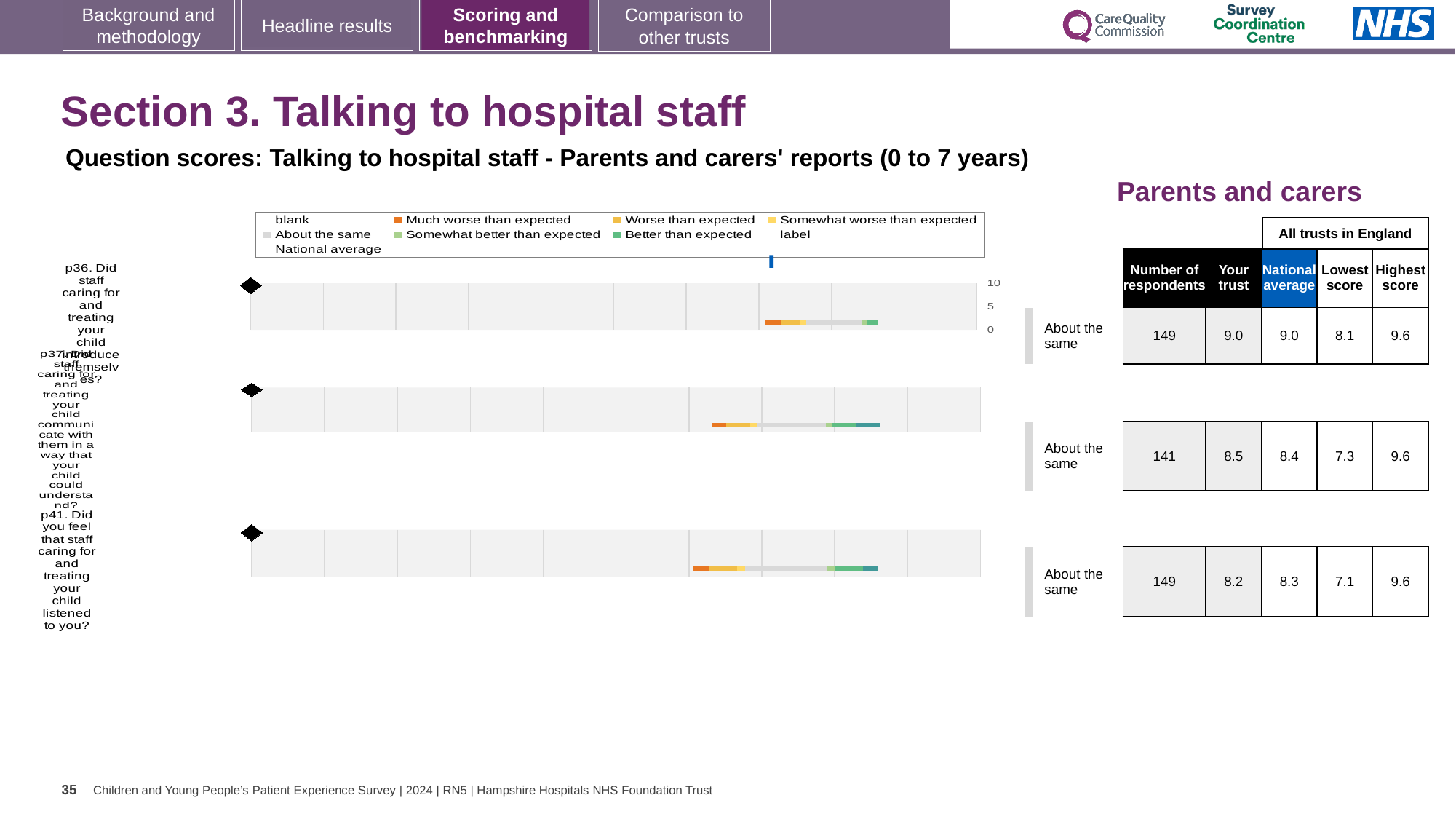
What is the difference between the 'Your trust' score and the national average for p37? 0.1 What is the highest score among all trusts in England for p37? 9.6 For p41, which is larger: the 'Your trust' score or the national average? National average How many survey questions are plotted in the chart? 3 What kind of chart is used to show the question scores on this slide? bar chart Which question has the highest 'Your trust' score? p36 What is the 'Your trust' score for p37 (Did staff communicate with your child in a way they could understand)? 8.5 What benchmark label is shown next to each of the three questions? About the same Which question has the lowest 'Lowest score' across all trusts in England? p41 What is the national average score for p41 (Did you feel that staff listened to you)? 8.3 What is the difference between the highest score and the lowest score for p36? 1.5 What is the number of respondents for p36 (Did staff caring for and treating your child introduce themselves)? 149